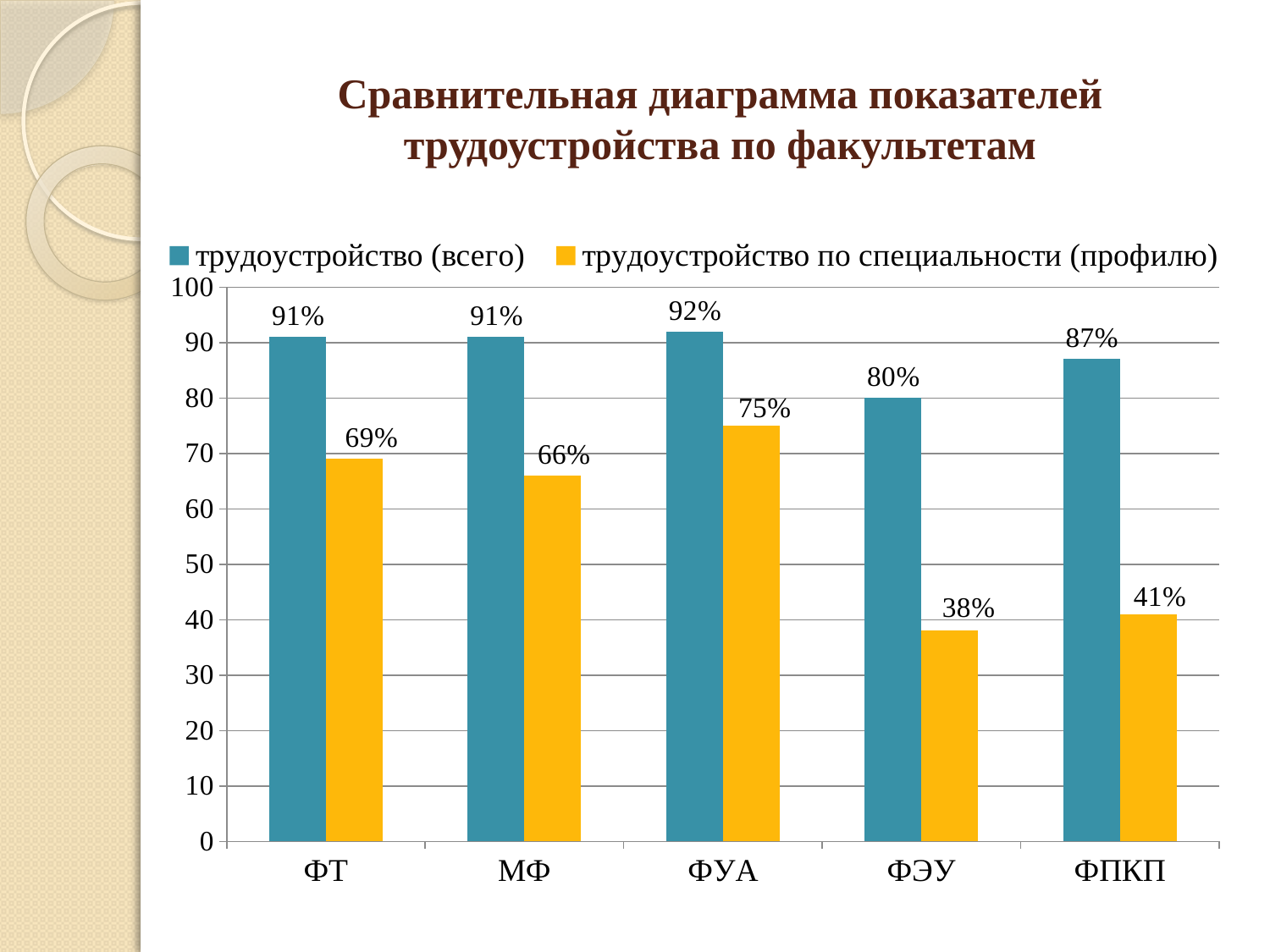
What colour are the bars for трудоустройство по специальности (профилю)? yellow Which faculty has the highest value for трудоустройство (всего)? ФУА What kind of chart is shown on the slide? bar chart What is the value of трудоустройство по специальности (профилю) for ФУА? 75% How many series does the legend list? 2 Which faculty has the lowest value for трудоустройство по специальности (профилю)? ФЭУ Is the value of трудоустройство по специальности (профилю) for ФЭУ greater or less than 40? less What is the value of трудоустройство (всего) for ФЭУ? 80% What is the difference between трудоустройство (всего) and трудоустройство по специальности (профилю) for ФЭУ? 42% What is the value of трудоустройство по специальности (профилю) for ФПКП? 41% How many faculties are shown on the x axis? 5 Which is larger: трудоустройство по специальности (профилю) for ФТ or for МФ? ФТ